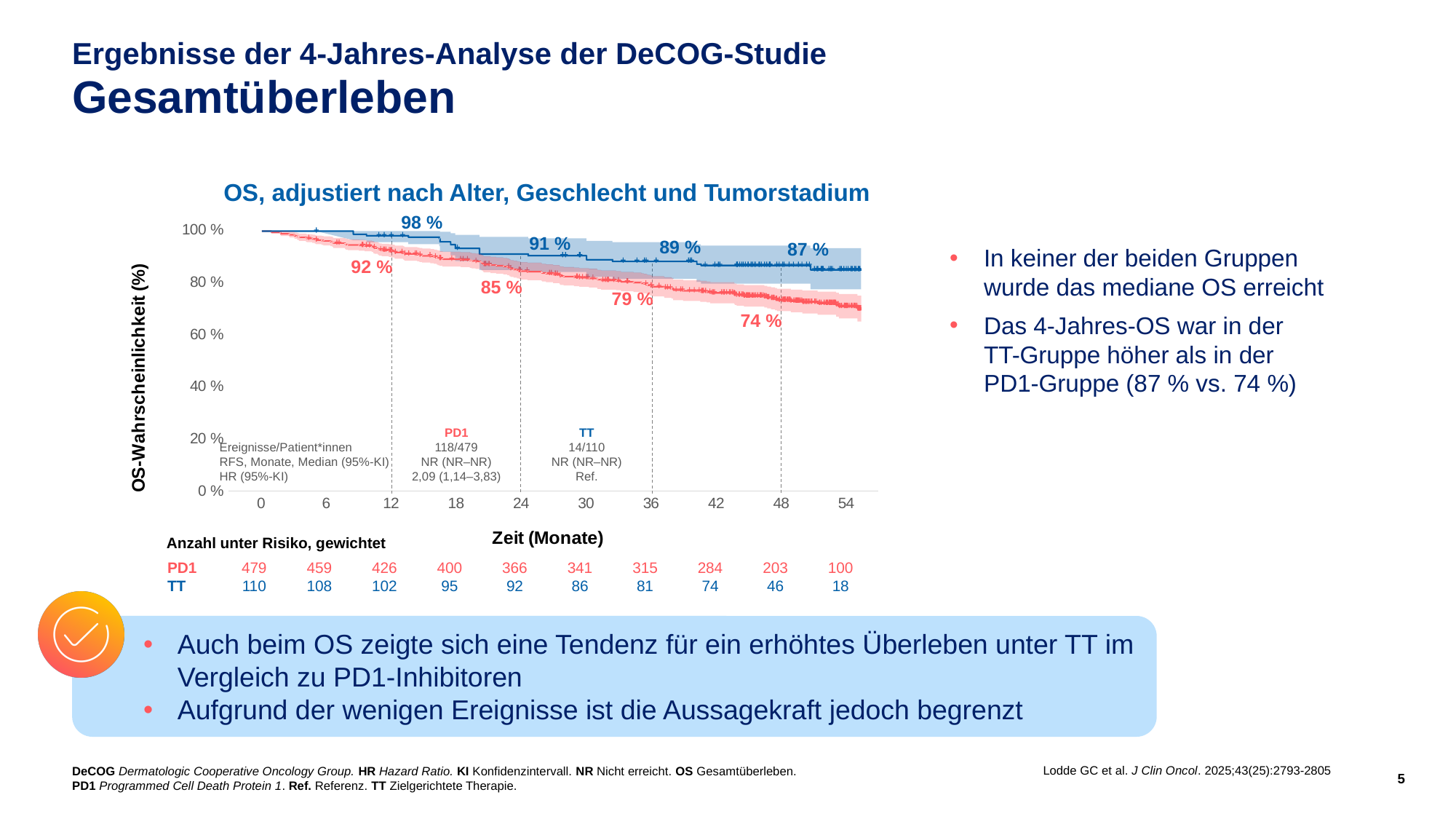
What is the difference between the TT and PD1 OS probabilities at 48 months? 13 % What is the OS probability for the TT group at 12 months? 98 % What is the label of the y axis? OS-Wahrscheinlichkeit (%) How many patients in the PD1 group were at risk at 0 months? 479 What is the title of the chart? OS, adjustiert nach Alter, Geschlecht und Tumorstadium What is the OS probability for the TT group at 36 months? 89 % Does the OS probability for the PD1 group rise or fall over time? fall Which group has the higher OS probability at 36 months, TT or PD1? TT What is the OS probability for the PD1 group at 24 months? 85 % How many patients in the TT group were at risk at 54 months? 18 What is the OS probability for the PD1 group at 48 months? 74 % What is the difference between the TT and PD1 OS probabilities at 12 months? 6 %